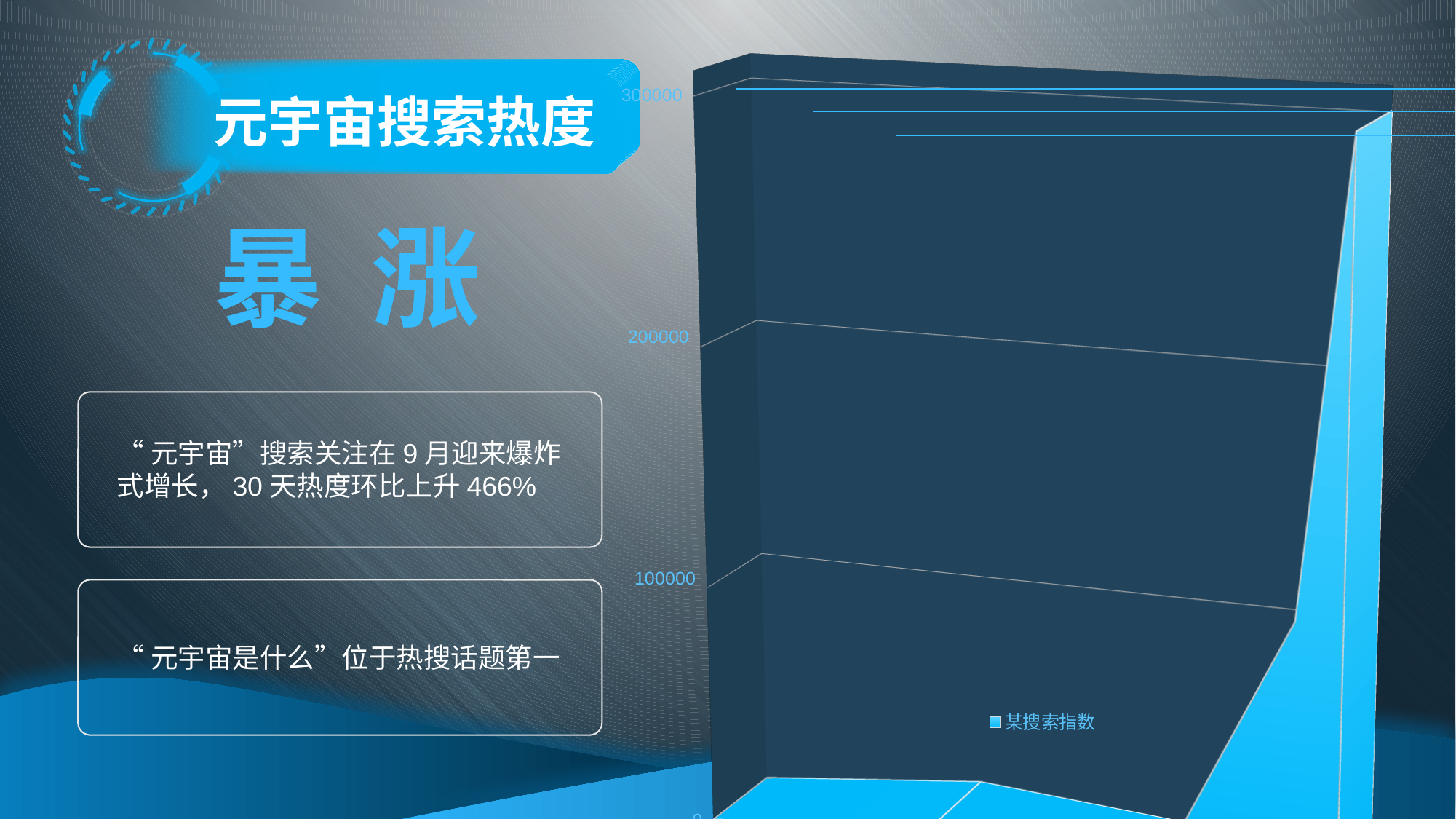
Is the highest value of 某搜索指数 greater or less than 200000? greater How many series does the chart's legend list? 1 Are the values of 某搜索指数 at the left end of the chart greater or less than 100000? less What is the highest tick label shown on the chart's vertical axis? 300000 What is the name of the series shown in the chart's legend? 某搜索指数 Do the values of 某搜索指数 rise or fall toward the right end of the x axis? rise What kind of chart is shown on the slide? area chart